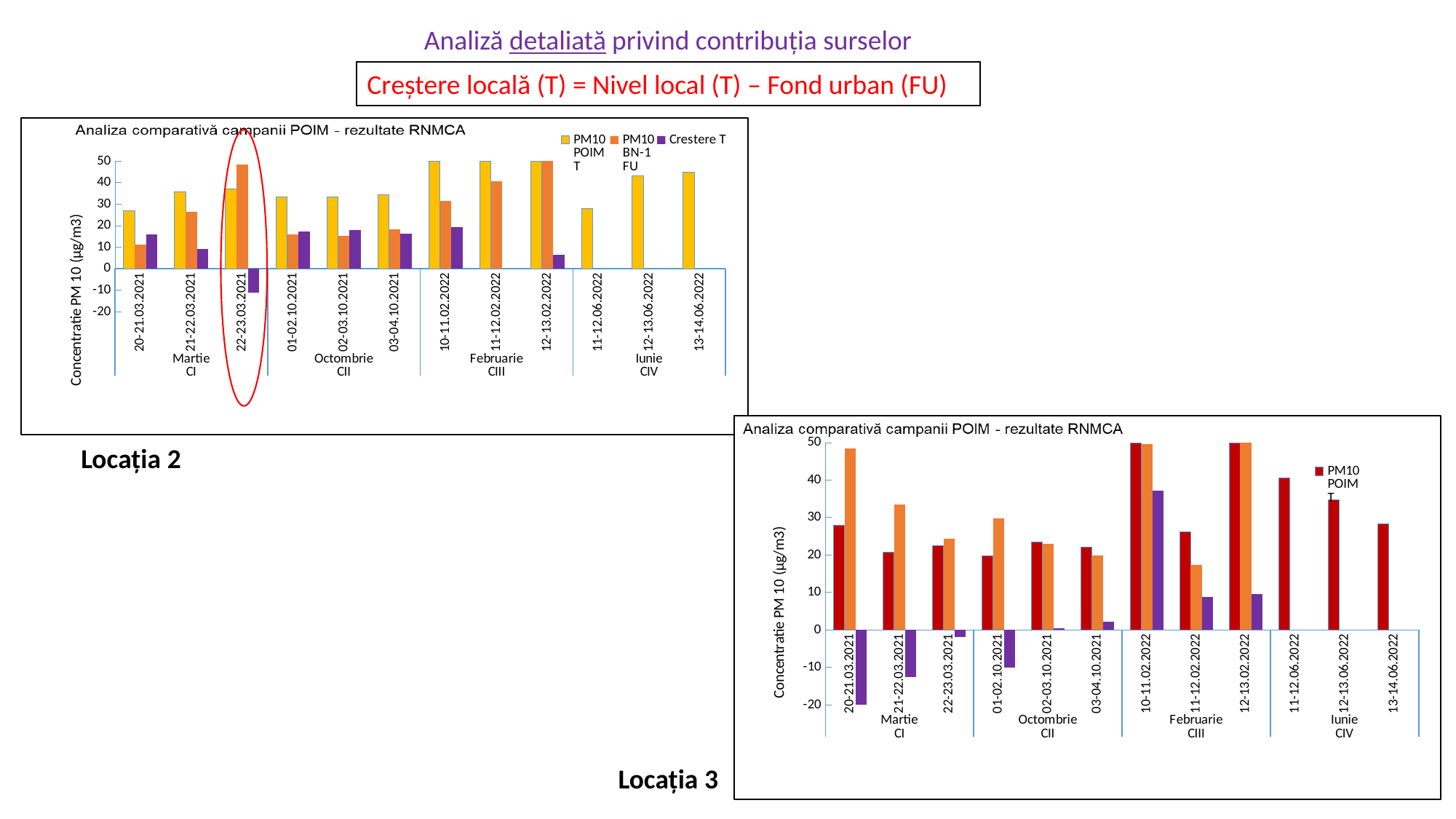
In the Locația 2 chart, which date has the lowest Crestere T value? 22-23.03.2021 In the Locația 3 chart, is the Crestere T value for 20-21.03.2021 greater or less than -10? less How many series does the legend of the Locația 2 chart list? 3 Which date category is circled in red on the Locația 2 chart? 22-23.03.2021 How many date categories are shown on the x axis of the Locația 3 chart? 12 In the Locația 3 chart, is the PM10 BN-1 FU value for 20-21.03.2021 greater or less than 40? greater What is the y-axis label of the Locația 3 chart? Concentratie PM 10 (µg/m3) In the Locația 3 chart, which date has the lowest Crestere T value? 20-21.03.2021 What kind of chart is the Locația 2 chart? bar chart In the Locația 2 chart, is the Crestere T value for 22-23.03.2021 greater or less than 0? less In the Locația 2 chart, which is larger for 22-23.03.2021: PM10 POIM T or PM10 BN-1 FU? PM10 BN-1 FU